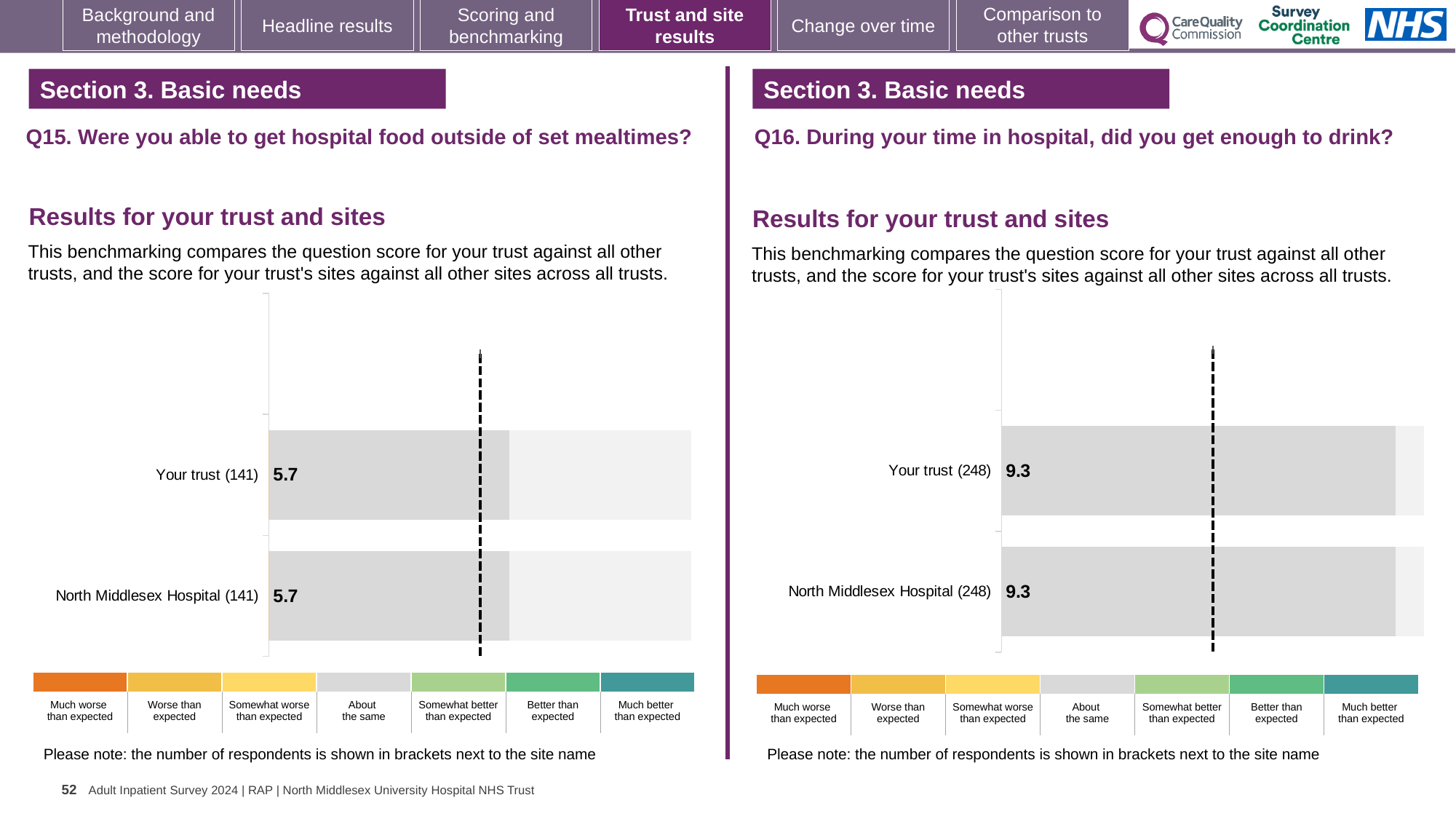
What kind of chart is used on the Q15 chart (left)? Bar chart On the Q16 chart (right), what is the score for Your trust? 9.3 On the Q16 chart (right), what is the score for North Middlesex Hospital? 9.3 What is the difference between the Your trust score and the North Middlesex Hospital score on the Q16 chart (right)? 0 On the Q15 chart (left), how many respondents are shown in brackets next to Your trust? 141 On the Q15 chart (left), what is the score for North Middlesex Hospital? 5.7 How many bars are plotted on the Q16 chart (right)? 2 On the Q16 chart (right), how many respondents are shown in brackets next to North Middlesex Hospital? 248 On the Q15 chart (left), what is the score for Your trust? 5.7 How many bars are plotted on the Q15 chart (left)? 2 Which is larger: the Your trust score on the Q15 chart (left) or the Your trust score on the Q16 chart (right)? Q16 chart (right)